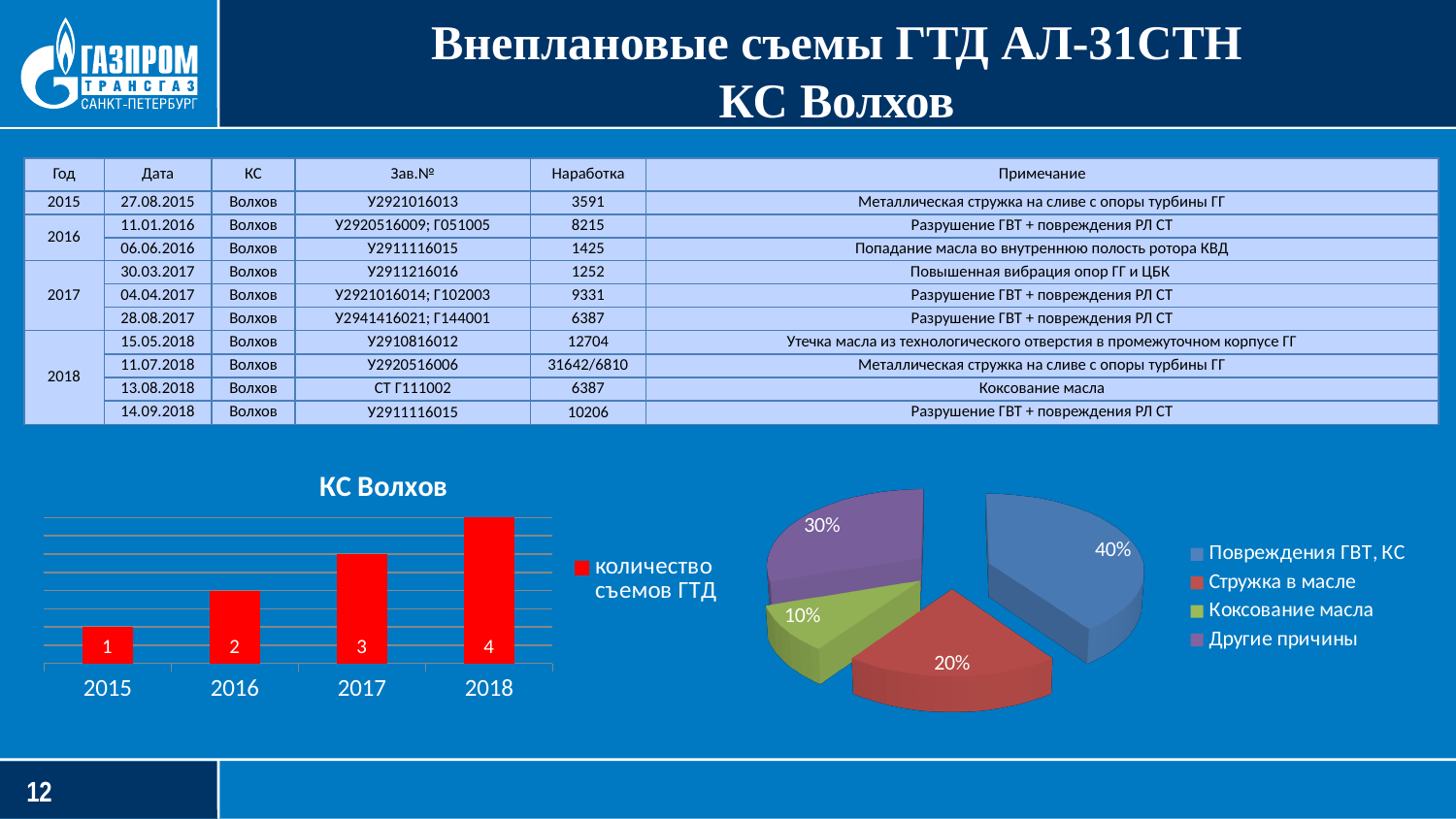
How many categories does the legend of the pie chart at the bottom right list? 4 On the pie chart at the bottom right, what share is labelled for 'Стружка в масле'? 20% What kind of chart is the chart titled 'КС Волхов' at the bottom left of the slide? bar chart On the bar chart titled 'КС Волхов', what is the value for 2015? 1 On the bar chart titled 'КС Волхов', do the values rise or fall from 2015 to 2018? rise On the bar chart titled 'КС Волхов', what is the value for 2017? 3 How many years are shown on the bar chart titled 'КС Волхов'? 4 On the bar chart titled 'КС Волхов', which year has the lowest value? 2015 On the pie chart at the bottom right, which category has the largest share? Повреждения ГВТ, КС On the bar chart titled 'КС Волхов', which year has the highest value? 2018 On the pie chart at the bottom right, which category has the smallest share? Коксование масла On the bar chart titled 'КС Волхов', what is the difference between the values for 2018 and 2016? 2